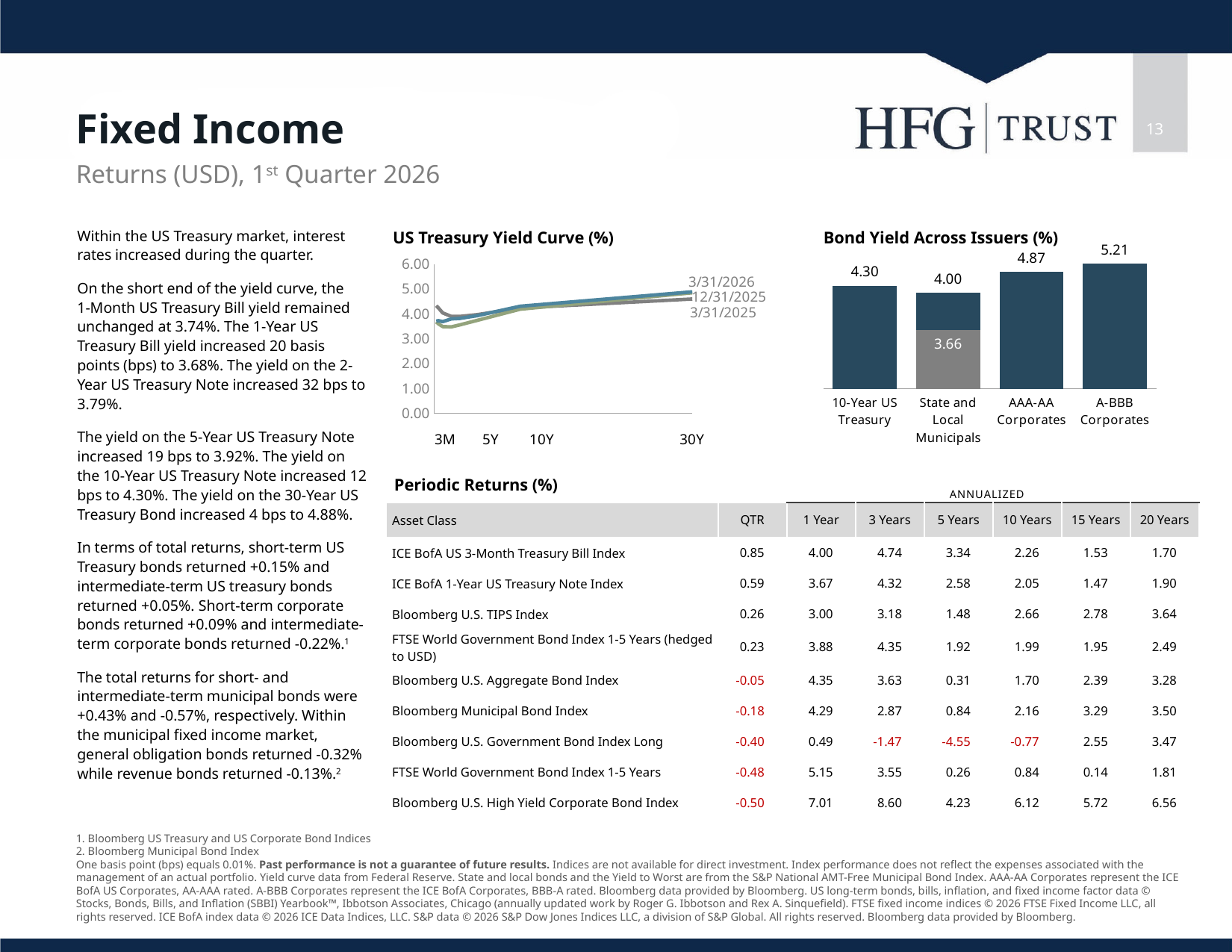
In the Bond Yield Across Issuers (%) chart, which issuer category has the highest yield? A-BBB Corporates In the Bond Yield Across Issuers (%) chart, which issuer category has the lowest top value? State and Local Municipals What kind of chart is the US Treasury Yield Curve (%) chart? Line chart What kind of chart is the Bond Yield Across Issuers (%) chart? Bar chart In the Bond Yield Across Issuers (%) chart, what is the yield for AAA-AA Corporates? 4.87 In the US Treasury Yield Curve (%) chart, do the yields generally rise or fall from 5Y to 30Y? Rise In the Bond Yield Across Issuers (%) chart, which is larger: the yield for AAA-AA Corporates or the yield for the 10-Year US Treasury? AAA-AA Corporates In the Bond Yield Across Issuers (%) chart, what is the yield for the 10-Year US Treasury? 4.30 In the Bond Yield Across Issuers (%) chart, what is the difference between the A-BBB Corporates yield and the 10-Year US Treasury yield? 0.91 In the Bond Yield Across Issuers (%) chart, what is the yield for A-BBB Corporates? 5.21 How many issuer categories are shown in the Bond Yield Across Issuers (%) chart? 4